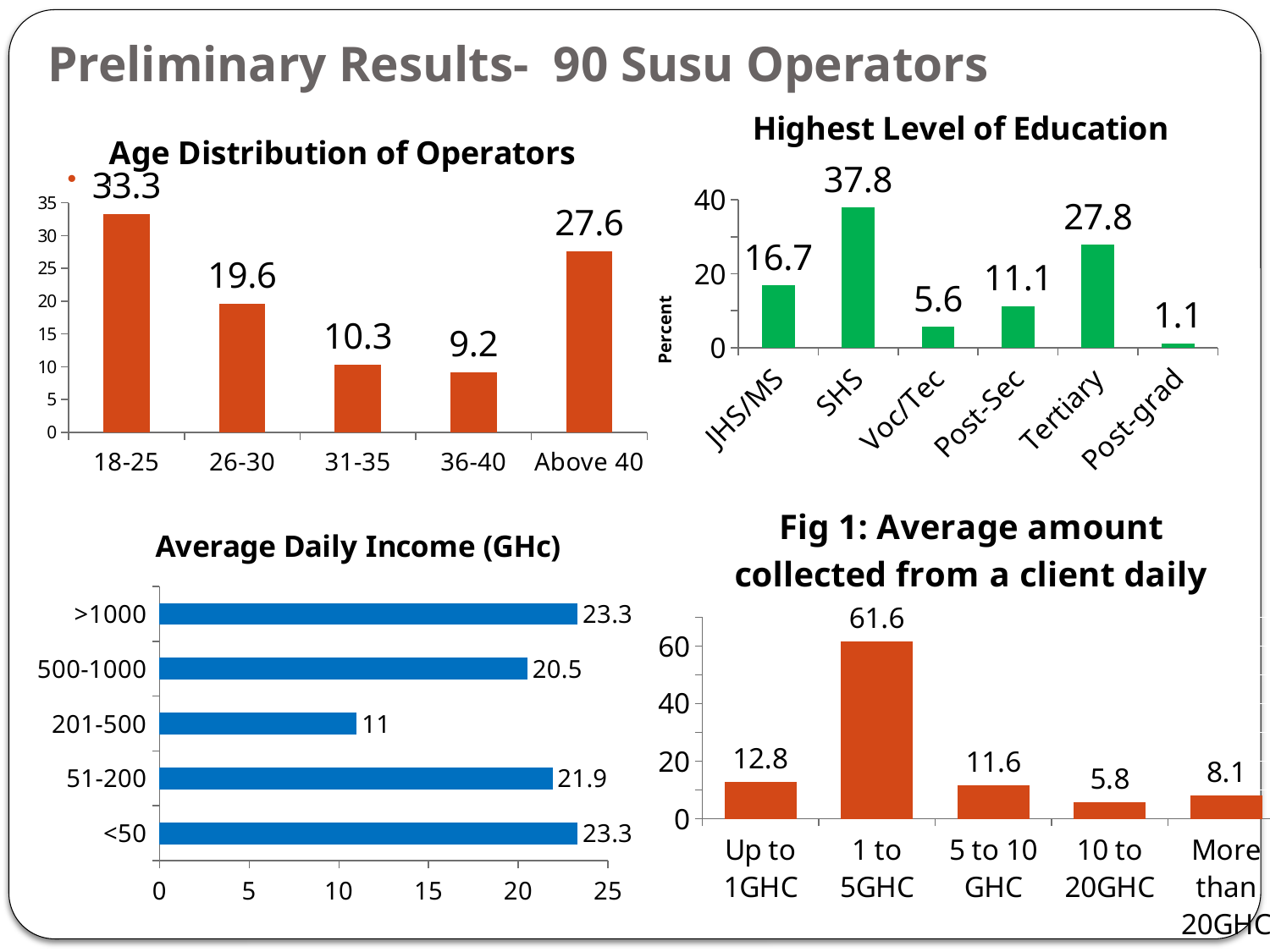
In the 'Average Daily Income (GHc)' chart, what is the value for the 201-500 category? 11 In the 'Fig 1: Average amount collected from a client daily' chart, what is the value for '1 to 5GHC'? 61.6 In the 'Fig 1: Average amount collected from a client daily' chart, what is the difference between the values for 'Up to 1GHC' and '5 to 10 GHC'? 1.2 In the 'Highest Level of Education' chart, which education level has the highest value? SHS What kind of chart is the 'Average Daily Income (GHc)' chart? Bar chart In the 'Highest Level of Education' chart, what is the value for Post-Sec? 11.1 In the 'Highest Level of Education' chart, which is larger, the value for JHS/MS or the value for Tertiary? Tertiary In the 'Age Distribution of Operators' chart, what is the value for the 26-30 age group? 19.6 How many categories are shown in the 'Highest Level of Education' chart? 6 In the 'Age Distribution of Operators' chart, which age group has the lowest value? 36-40 In the 'Fig 1: Average amount collected from a client daily' chart, which category has the lowest value? 10 to 20GHC In the 'Age Distribution of Operators' chart, what is the difference between the values for 18-25 and Above 40? 5.7